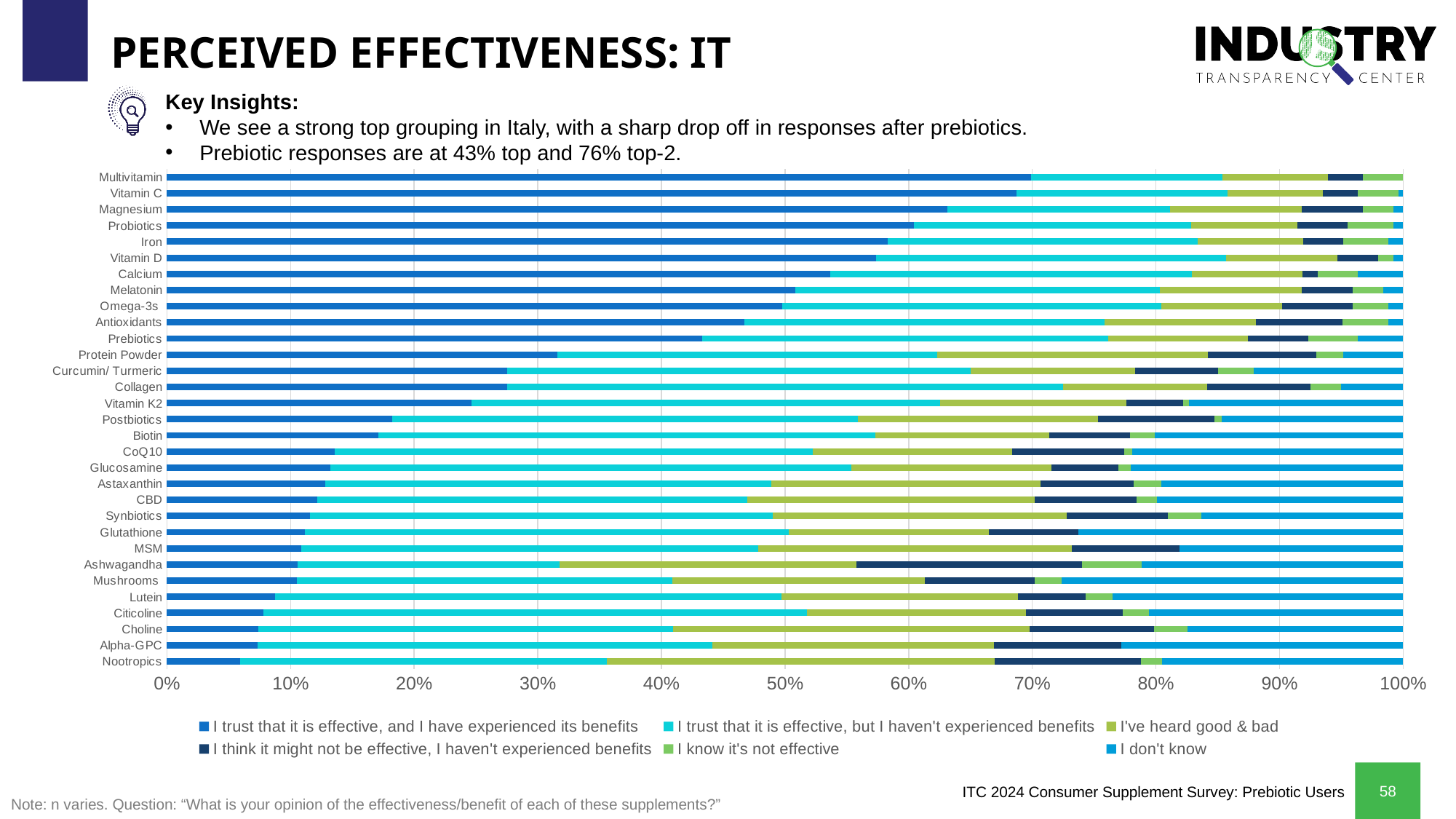
What is the title of the slide containing the chart? PERCEIVED EFFECTIVENESS: IT According to the slide, what percentage of Prebiotics responses are in the top category (trust it is effective and have experienced benefits)? 43% How many series does the legend list? 6 According to the slide, what is the top-2 percentage for Prebiotics? 76% Is the share of respondents who trust Nootropics is effective and have experienced its benefits greater or less than 10%? less Is the share of respondents who trust Multivitamin is effective and have experienced its benefits greater or less than 60%? greater How many supplement categories are listed on the chart? 31 Which supplement has the smallest share of respondents who trust that it is effective and have experienced its benefits? Nootropics What kind of chart is shown on the slide? Stacked bar chart Moving from the top of the chart to the bottom, does the share of respondents who trust the supplement is effective and have experienced its benefits rise or fall? Fall Which supplement has the largest share of respondents who trust that it is effective and have experienced its benefits? Multivitamin Which has a larger share of respondents who trust it is effective and have experienced its benefits: Iron or Prebiotics? Iron